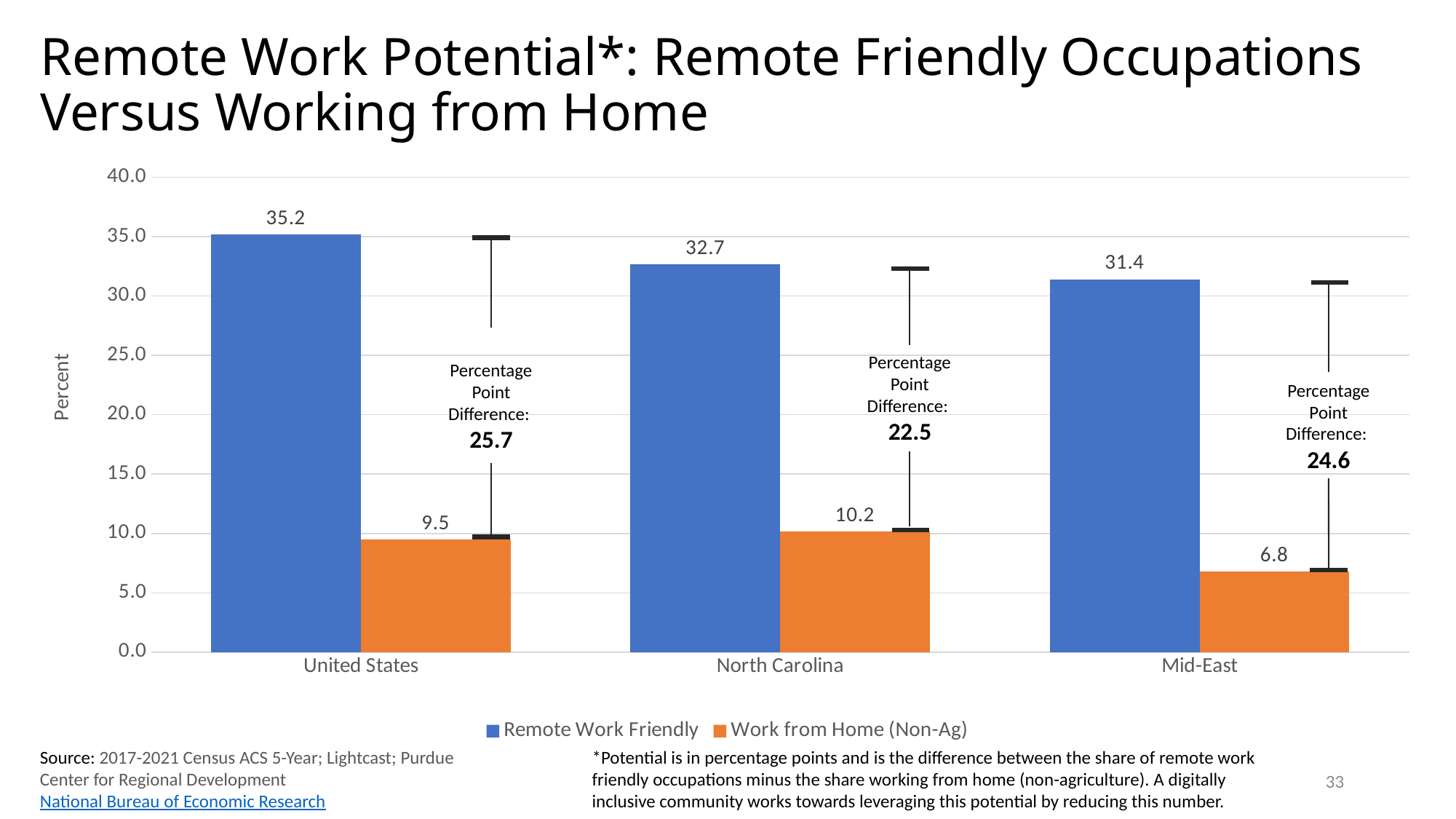
Is the Remote Work Friendly value for Mid-East greater or less than 30.0? greater What is the Remote Work Friendly value for the United States? 35.2 How many series does the legend list? 2 What is the Work from Home (Non-Ag) value for North Carolina? 10.2 How many regions are shown on the x axis? 3 What is the difference between the Remote Work Friendly and Work from Home (Non-Ag) values for North Carolina? 22.5 What kind of chart is shown on the slide? Bar chart Which region has the lowest Work from Home (Non-Ag) value? Mid-East What is the Work from Home (Non-Ag) value for Mid-East? 6.8 Which is larger, the Work from Home (Non-Ag) value for the United States or for North Carolina? North Carolina What is the difference between the Remote Work Friendly values for the United States and Mid-East? 3.8 Which region has the highest Remote Work Friendly value? United States